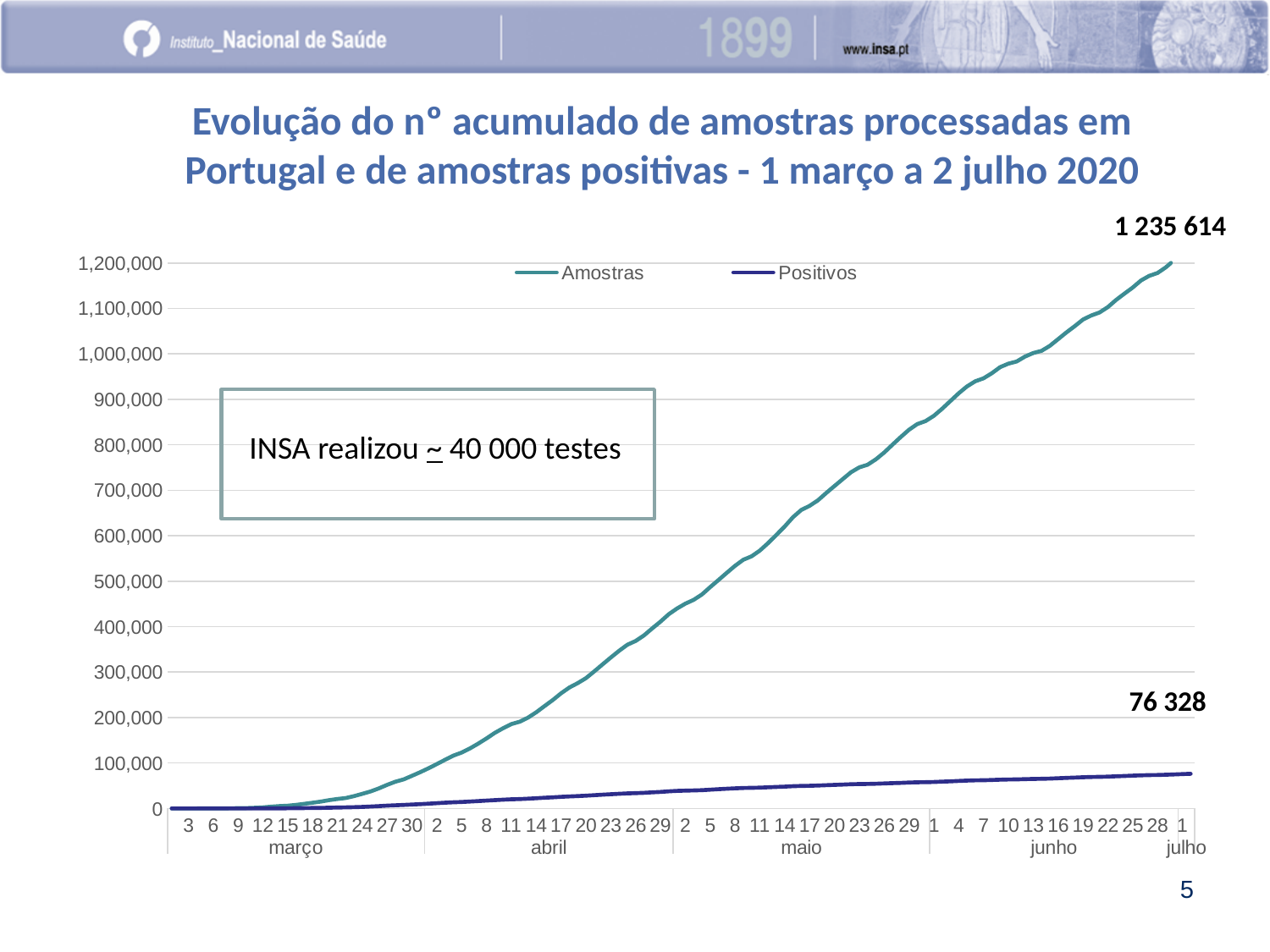
How many series does the chart legend list? 2 At the end of the period (1 julho), which series has the larger value, Amostras or Positivos? Amostras How many months are labelled along the x axis of the chart? 5 Is the final value of the Positivos series greater or less than 100,000? less What is the final labelled value of the Positivos series on the chart? 76 328 Is the value of the Amostras series on 1 junho greater or less than 800,000? greater What is the difference between the final labelled values of Amostras (1 235 614) and Positivos (76 328)? 1 159 286 Is the value of the Amostras series on 30 março greater or less than 100,000? less What kind of chart is shown on the slide? Line chart What is the final labelled value of the Amostras series on the chart? 1 235 614 What are the two series names shown in the chart legend? Amostras and Positivos Do the values of the Amostras series rise or fall over time along the x axis? Rise